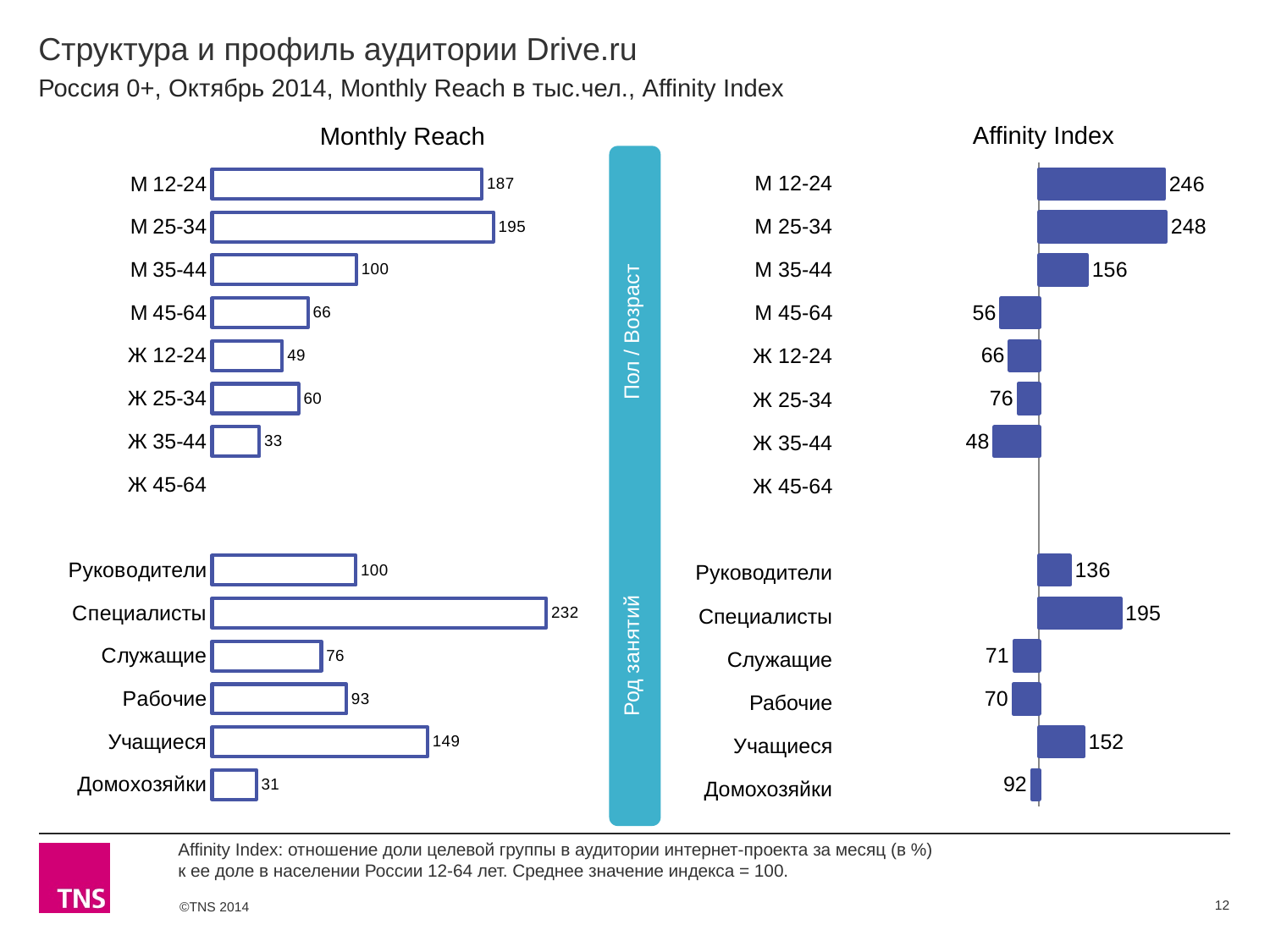
How many category labels are listed in the Monthly Reach chart? 14 In the Affinity Index chart, what is the value for Ж 35-44? 48 In the Monthly Reach chart, which category has the highest value? Специалисты In the Affinity Index chart, which is larger: the value for М 35-44 or the value for Руководители? М 35-44 In the Monthly Reach chart, which is larger: the value for Учащиеся or the value for Рабочие? Учащиеся In the Monthly Reach chart, what is the value for Домохозяйки? 31 In the Affinity Index chart, what is the difference between the values for Специалисты and Руководители? 59 In the Affinity Index chart, what is the value for Учащиеся? 152 In the Monthly Reach chart, what is the difference between the values for М 25-34 and М 12-24? 8 In the Affinity Index chart, which category has the highest value? М 25-34 In the Monthly Reach chart, what is the value for М 25-34? 195 What kind of chart is the Affinity Index chart? Bar chart